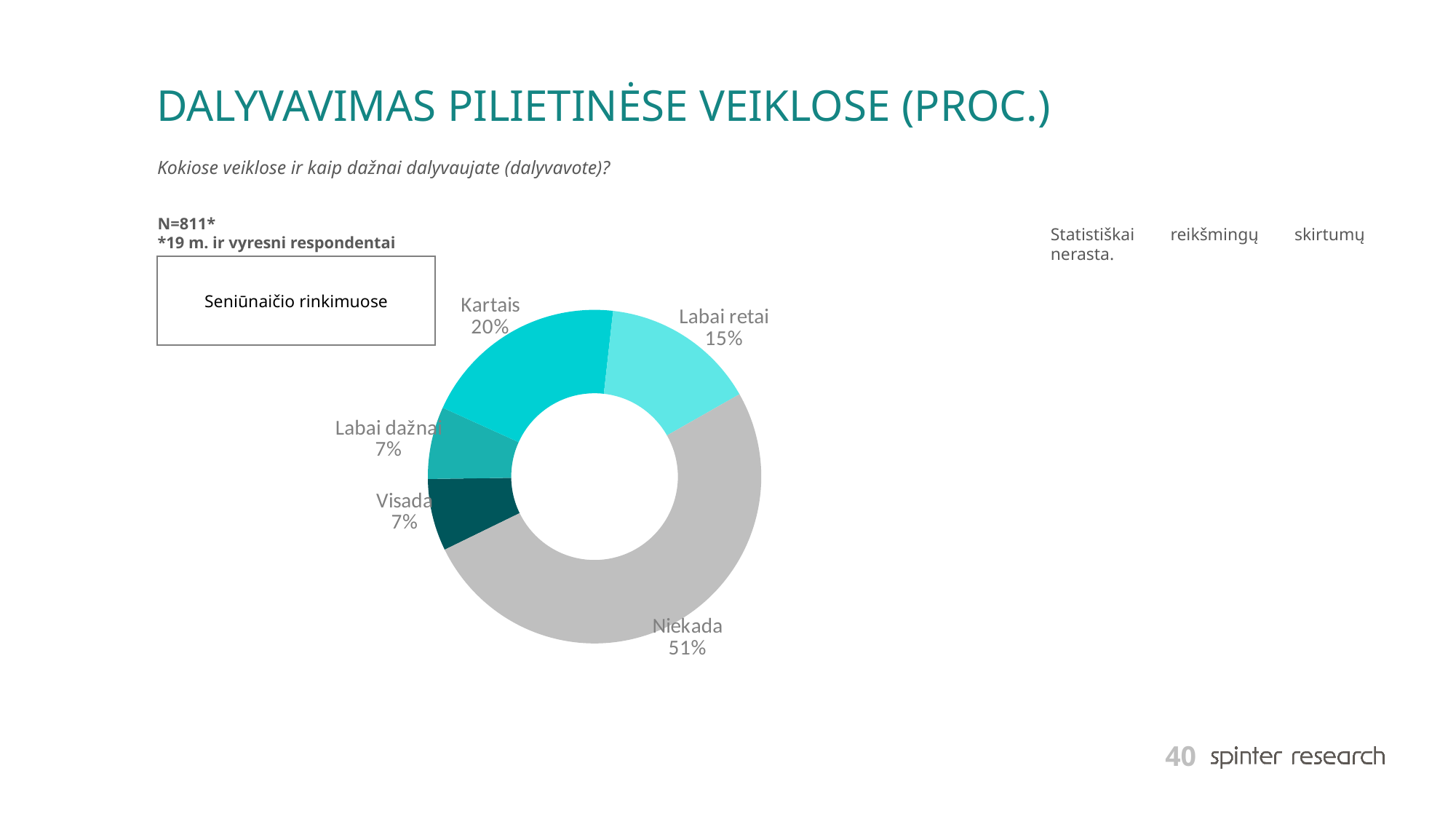
What is the label in the box above the chart? Seniūnaičio rinkimuose What value is shown for "Labai retai"? 15% What percentage is shown for "Visada"? 7% What share is shown for "Kartais"? 20% How many categories are shown in the chart? 5 What type of chart is shown on the slide? Doughnut chart What is the sample size (N) stated on the slide? N=811* Which category has the largest share of the chart? Niekada What percentage of respondents answered "Niekada" in the Seniūnaičio rinkimuose chart? 51% What is the combined share of "Labai dažnai" and "Visada"? 14% Which is larger, the share for "Kartais" or the share for "Labai retai"? Kartais What is the difference in percentage points between "Niekada" and "Kartais"? 31